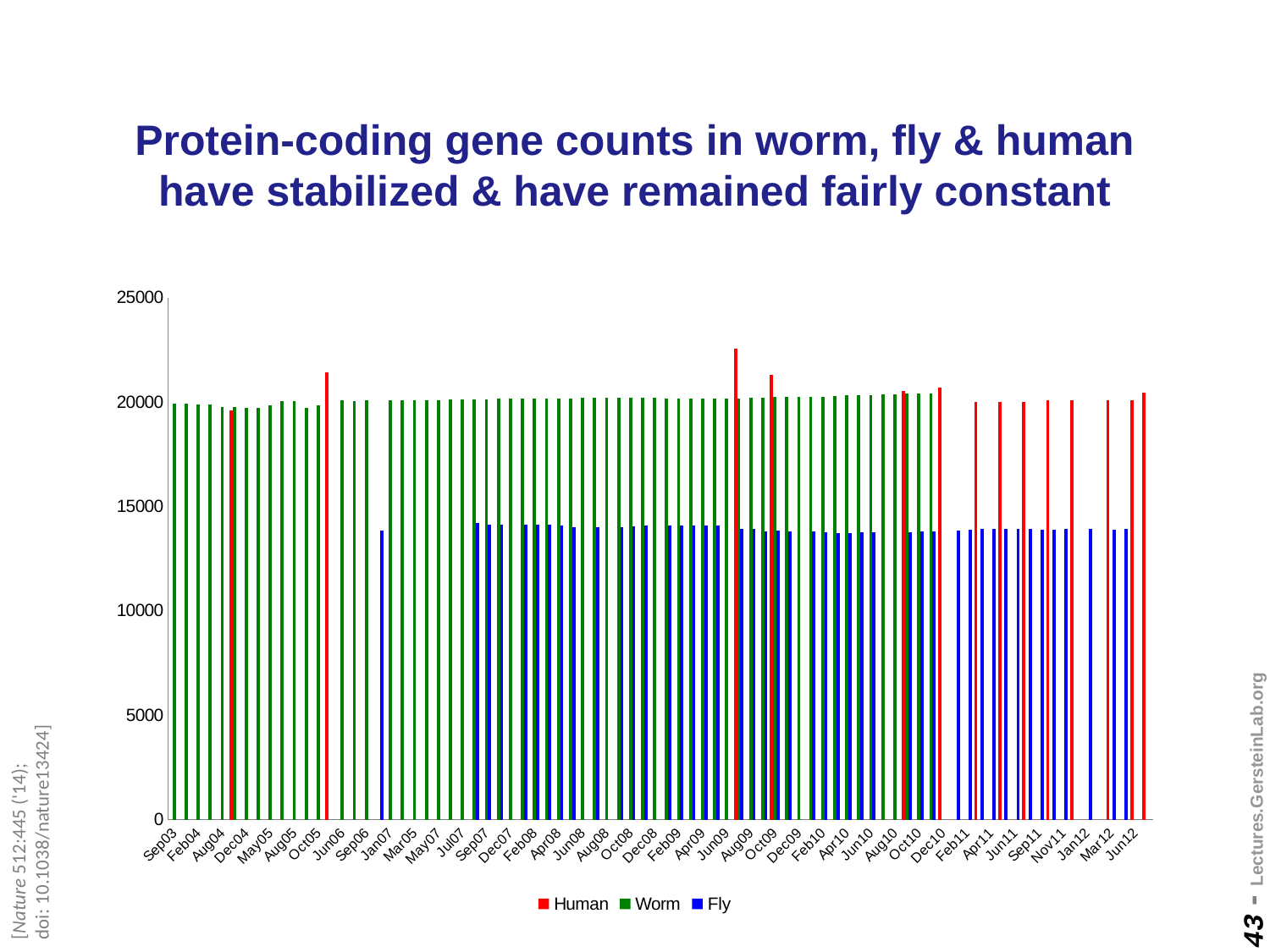
Which series has the lowest values throughout the chart? Fly Which series are listed in the legend? Human, Worm, Fly Which colour represents the Fly series? blue How many series does the legend list? 3 Which is larger in Feb08, the Worm value or the Fly value? Worm Which series has the single tallest bar on the chart? Human Is the value for Worm in Sep03 greater or less than 15000? greater What kind of chart is shown on the slide? bar chart